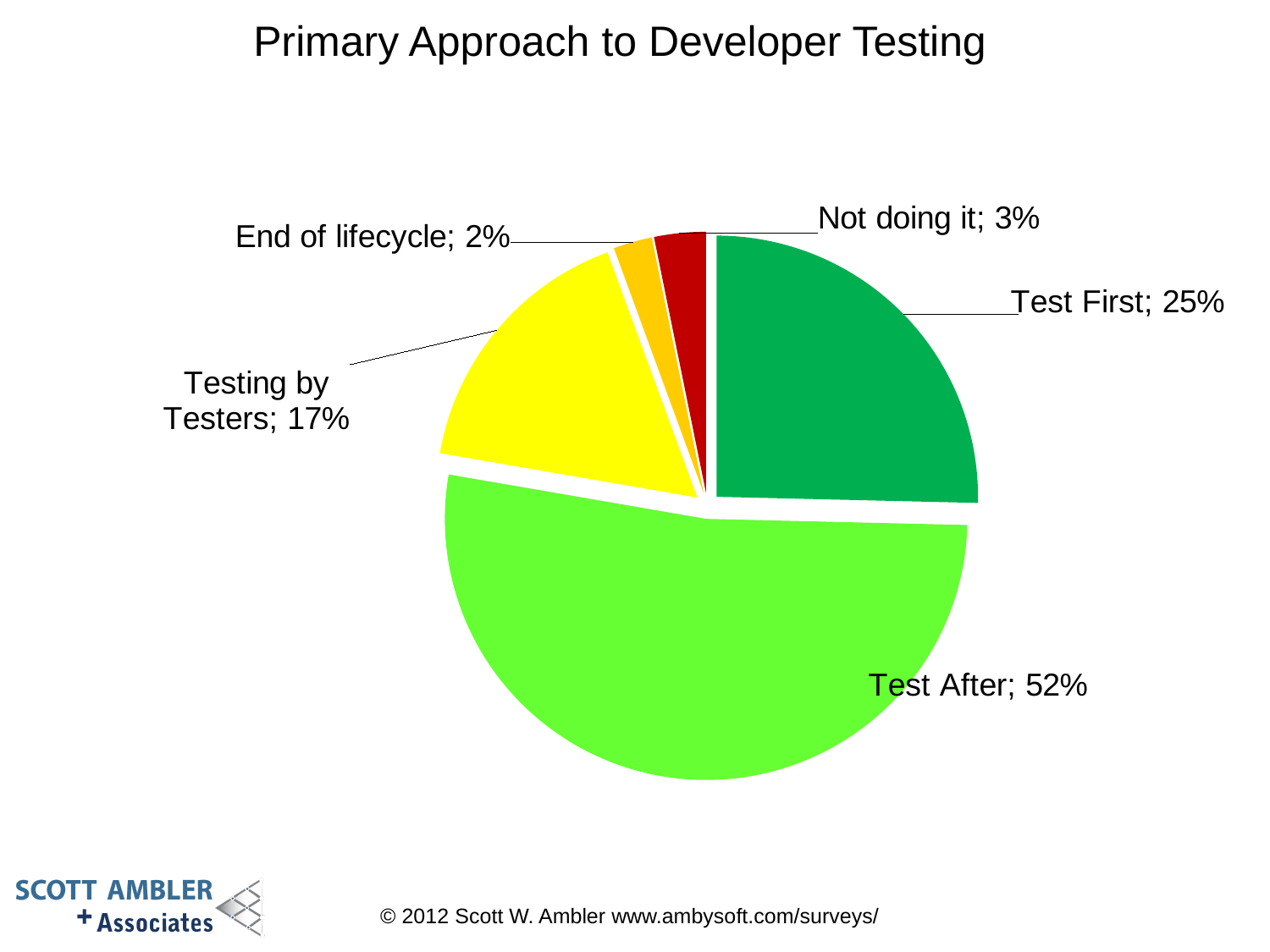
What is the difference in percentage points between Test After and Test First? 27 What kind of chart is shown on the slide? pie chart Which category has the smallest slice of the pie? End of lifecycle What share of the pie is Test First? 25% How many slices does the pie chart have? 5 What share of the pie is Test After? 52% What is the title of the chart? Primary Approach to Developer Testing Which is larger, Testing by Testers or Test First? Test First What share of the pie is Testing by Testers? 17% What share of the pie is End of lifecycle? 2% What share of the pie is Not doing it? 3% Which category has the largest slice of the pie? Test After